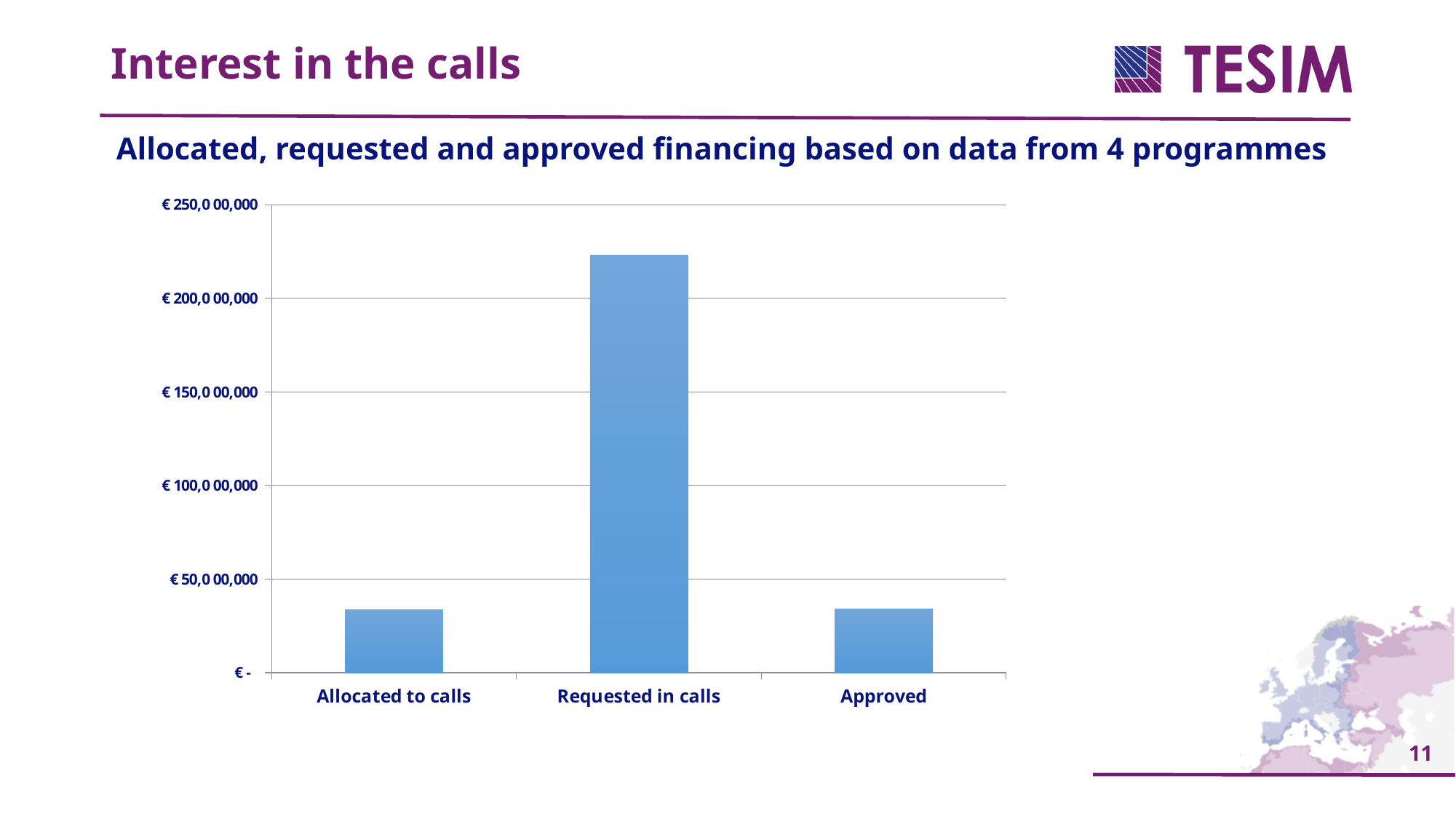
How many categories are plotted on the chart? 3 Which is larger, the value for Requested in calls or the value for Allocated to calls? Requested in calls Is the value for Allocated to calls greater or less than € 50,000,000? less What colour are the bars in the chart? blue Is the value for Approved greater or less than € 50,000,000? less Is the value for Requested in calls greater or less than € 250,000,000? less What kind of chart is shown on the slide? bar chart Which is larger, the value for Approved or the value for Requested in calls? Requested in calls What is the title of the chart? Allocated, requested and approved financing based on data from 4 programmes Which category has the highest value? Requested in calls